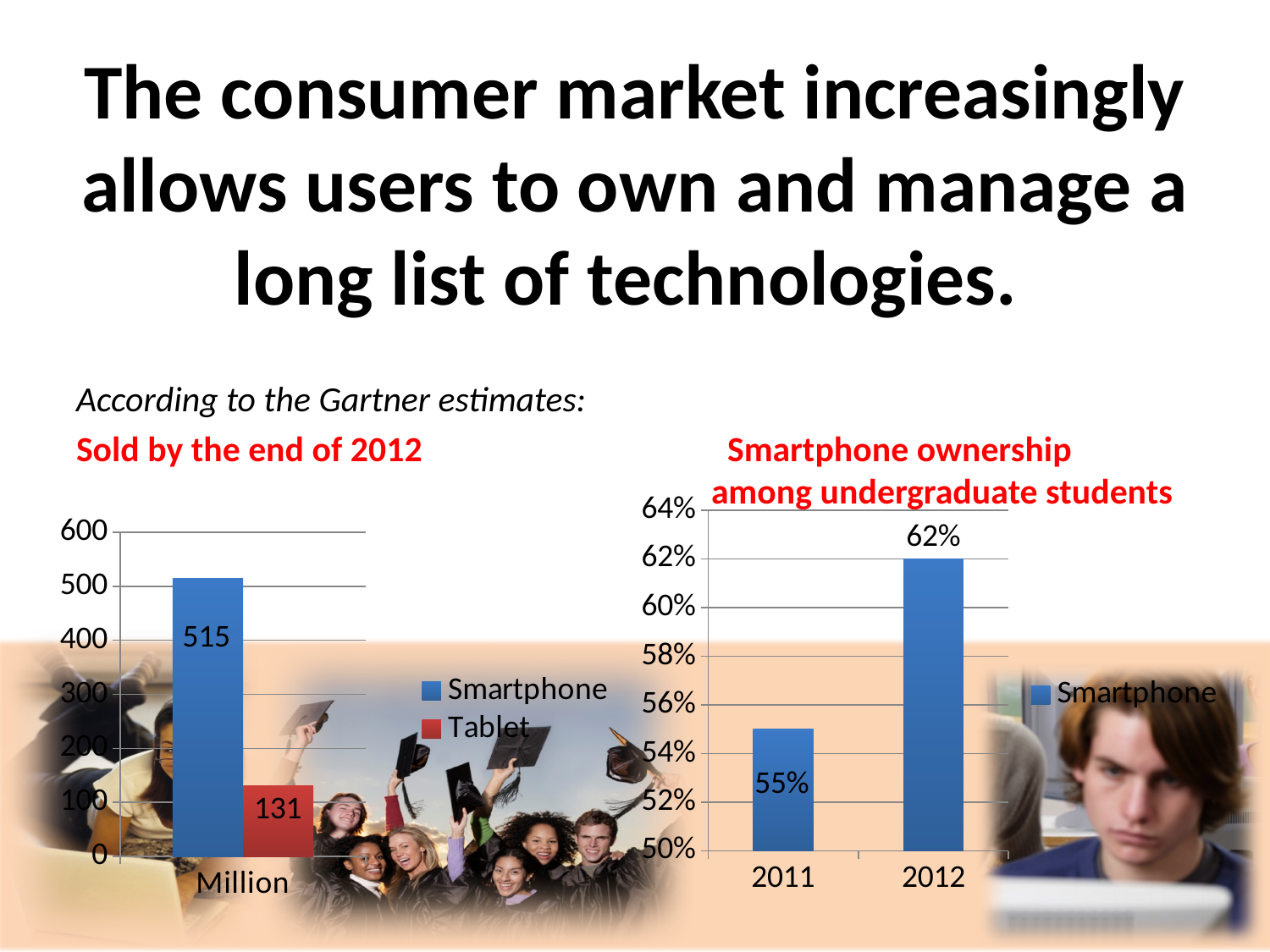
In the 'Sold by the end of 2012' chart, what is the category label on the x axis? Million In the 'Smartphone ownership among undergraduate students' chart, what is the value for 2012? 62% In the 'Sold by the end of 2012' chart, what is the difference between the Smartphone and Tablet values? 384 In the 'Smartphone ownership among undergraduate students' chart, by how much did the value increase from 2011 to 2012? 7% In the 'Smartphone ownership among undergraduate students' chart, do the values rise or fall from 2011 to 2012? rise In the 'Sold by the end of 2012' chart, how many series does the legend list? 2 What kind of chart is the 'Smartphone ownership among undergraduate students' chart? bar chart In the 'Smartphone ownership among undergraduate students' chart, what is the value for 2011? 55% In the 'Sold by the end of 2012' chart, what is the value for Tablet? 131 In the 'Sold by the end of 2012' chart, which series has the larger value, Smartphone or Tablet? Smartphone In the 'Sold by the end of 2012' chart, what is the value for Smartphone? 515 In the 'Smartphone ownership among undergraduate students' chart, how many categories are shown on the x axis? 2